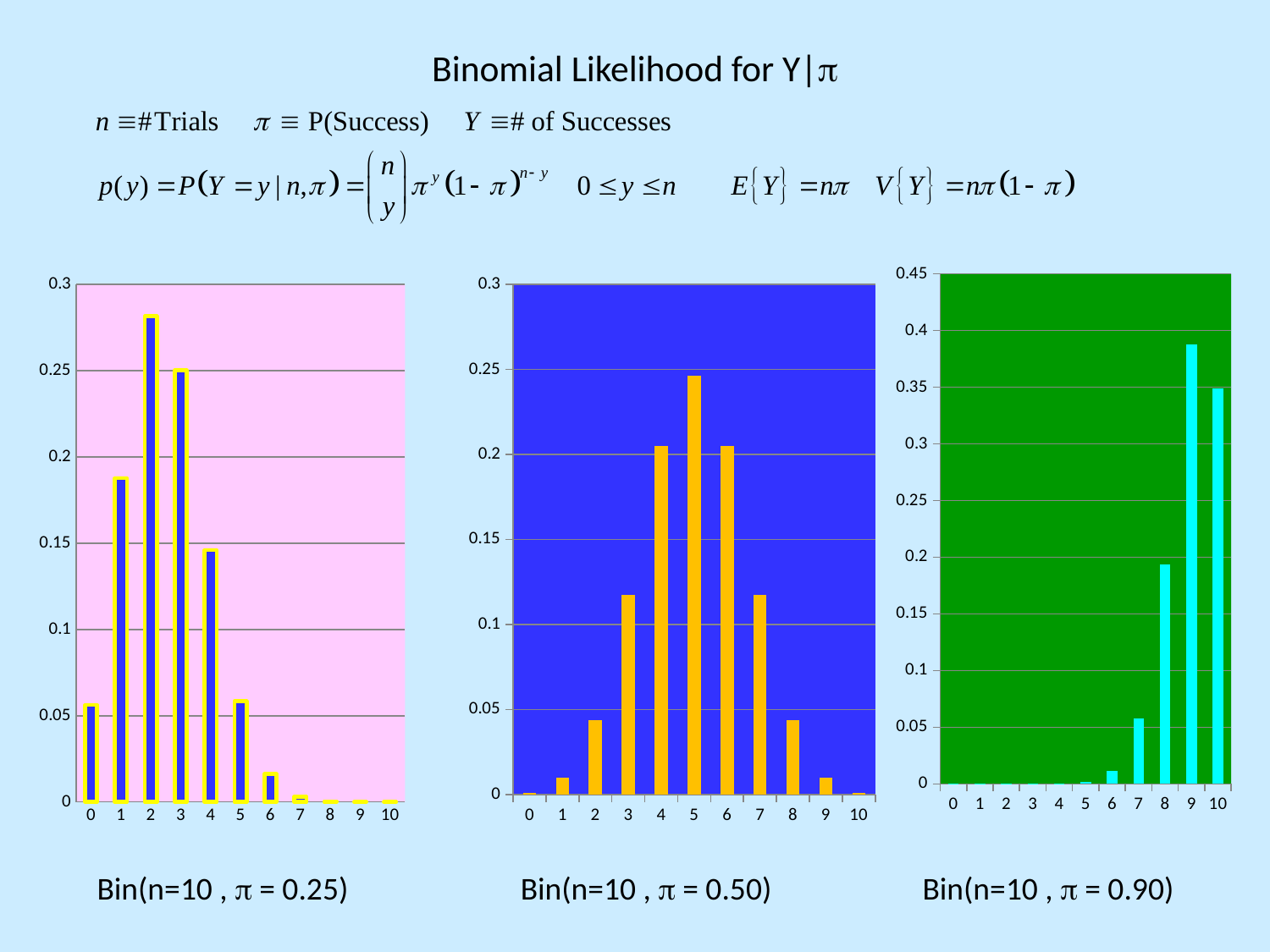
In the Bin(n=10, π = 0.90) chart on the right, is the value for category 9 greater or less than 0.35? greater In the Bin(n=10, π = 0.25) chart on the left, is the value for category 1 greater or less than 0.15? greater What is the highest tick value on the y axis of the Bin(n=10, π = 0.90) chart on the right? 0.45 In the Bin(n=10, π = 0.25) chart on the left, which category has the highest bar? 2 What kind of chart is the Bin(n=10, π = 0.25) chart on the left? bar chart In the Bin(n=10, π = 0.50) chart in the middle, which is larger, the value for category 4 or the value for category 3? 4 In the Bin(n=10, π = 0.50) chart in the middle, is the value for category 5 greater or less than 0.2? greater In the Bin(n=10, π = 0.90) chart on the right, which category has the highest bar? 9 In the Bin(n=10, π = 0.90) chart on the right, do the values generally rise or fall as the x axis goes from 0 to 9? rise In the Bin(n=10, π = 0.50) chart in the middle, which category has the highest bar? 5 How many categories are shown on the x axis of the Bin(n=10, π = 0.50) chart in the middle? 11